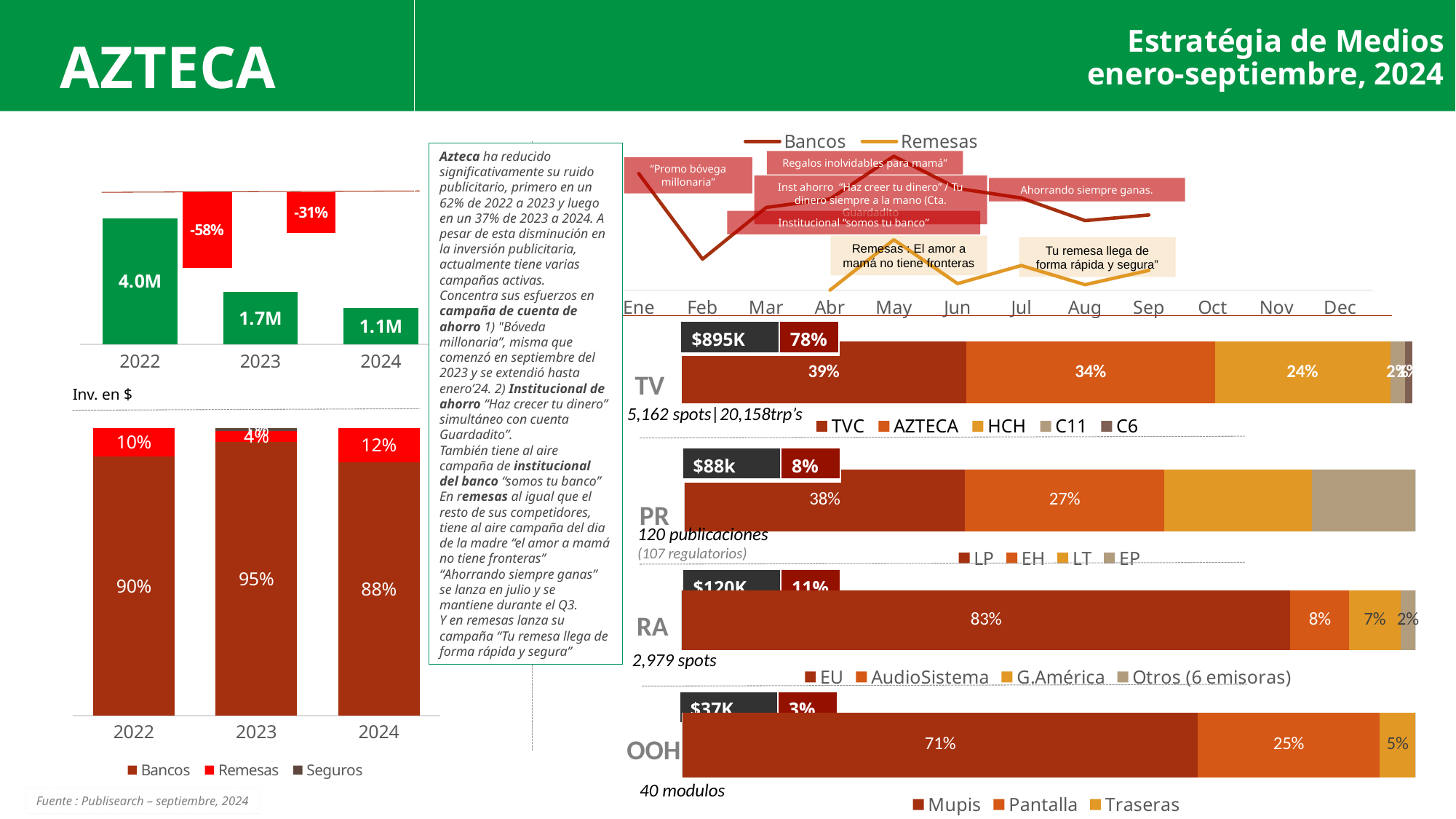
In the OOH horizontal stacked bar on the right, what is the difference between the Mupis share and the Pantalla share? 46% In the 'Inv. en $' stacked bar chart, what share does Bancos have in 2023? 95% In the top-left bar chart of investment by year, what is the value for 2022? 4.0M In the RA horizontal stacked bar on the right, what share does EU have? 83% In the 'Inv. en $' stacked bar chart, which year has the lowest Remesas share? 2023 In the top-left bar chart of investment by year, what percentage change is shown between 2022 and 2023? -58% In the 'Inv. en $' stacked bar chart, what share does Remesas have in 2024? 12% In the top-left bar chart of investment by year, how many years are shown? 3 In the 'Inv. en $' stacked bar chart, how many series does the legend list? 3 In the top-left bar chart of investment by year, what is the value for 2024? 1.1M In the TV horizontal stacked bar on the right, what share does TVC have? 39% In the top-left bar chart of investment by year, which year has the highest investment? 2022